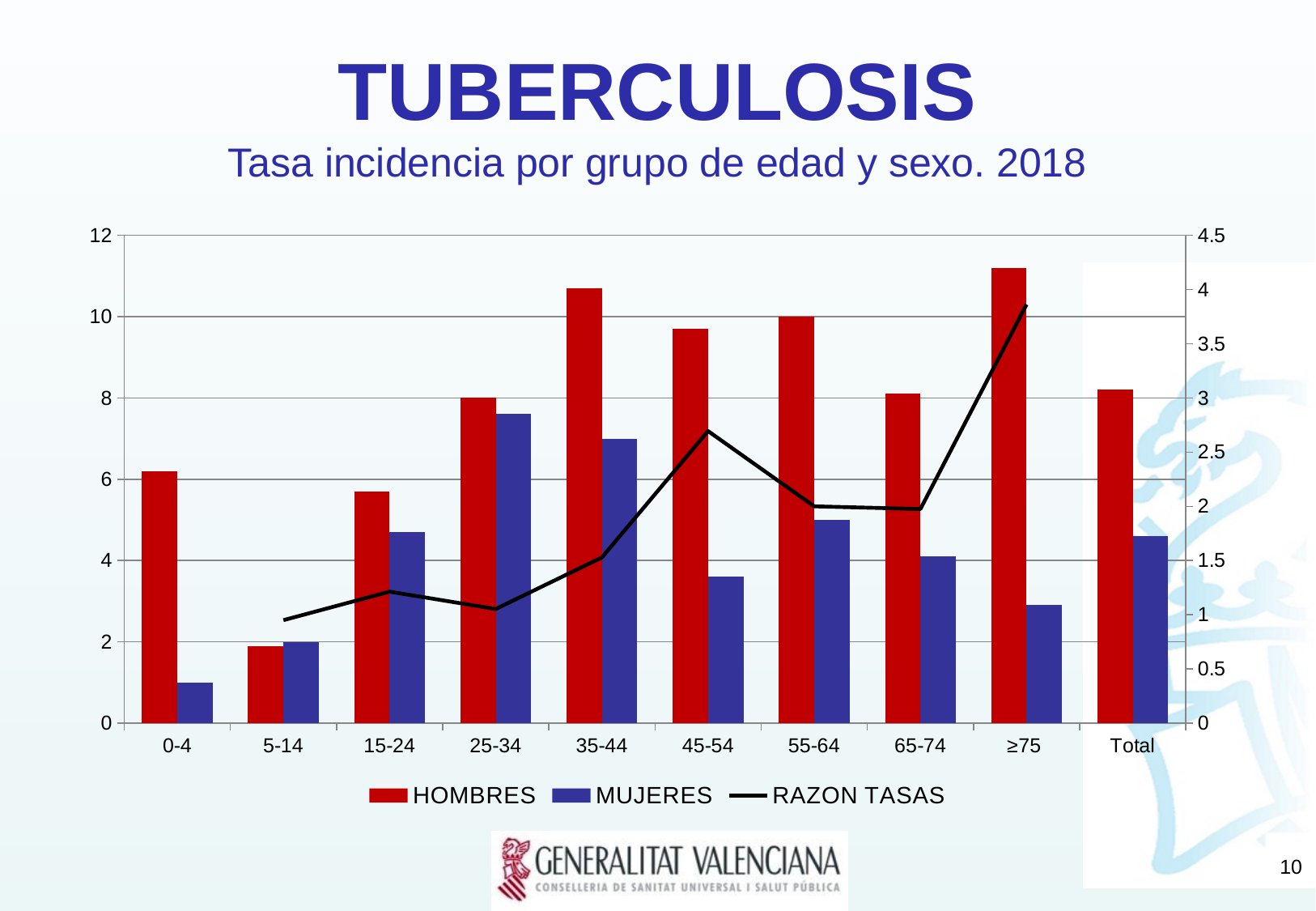
Which age group has the highest HOMBRES value? ≥75 Which age group has the lowest HOMBRES value? 5-14 Is the HOMBRES value for 35-44 greater or less than 10? greater Does the RAZON TASAS line rise or fall between 65-74 and ≥75? rise How many age-group categories are shown on the x axis, including Total? 10 Is the HOMBRES value for 0-4 greater or less than 5? greater Which age group has the lowest MUJERES value? 0-4 For the 45-54 age group, which is larger, HOMBRES or MUJERES? HOMBRES Is the MUJERES value for 45-54 greater or less than 4? less How many series does the legend list? 3 What colour are the HOMBRES bars? Red Which age group has the highest MUJERES value? 25-34